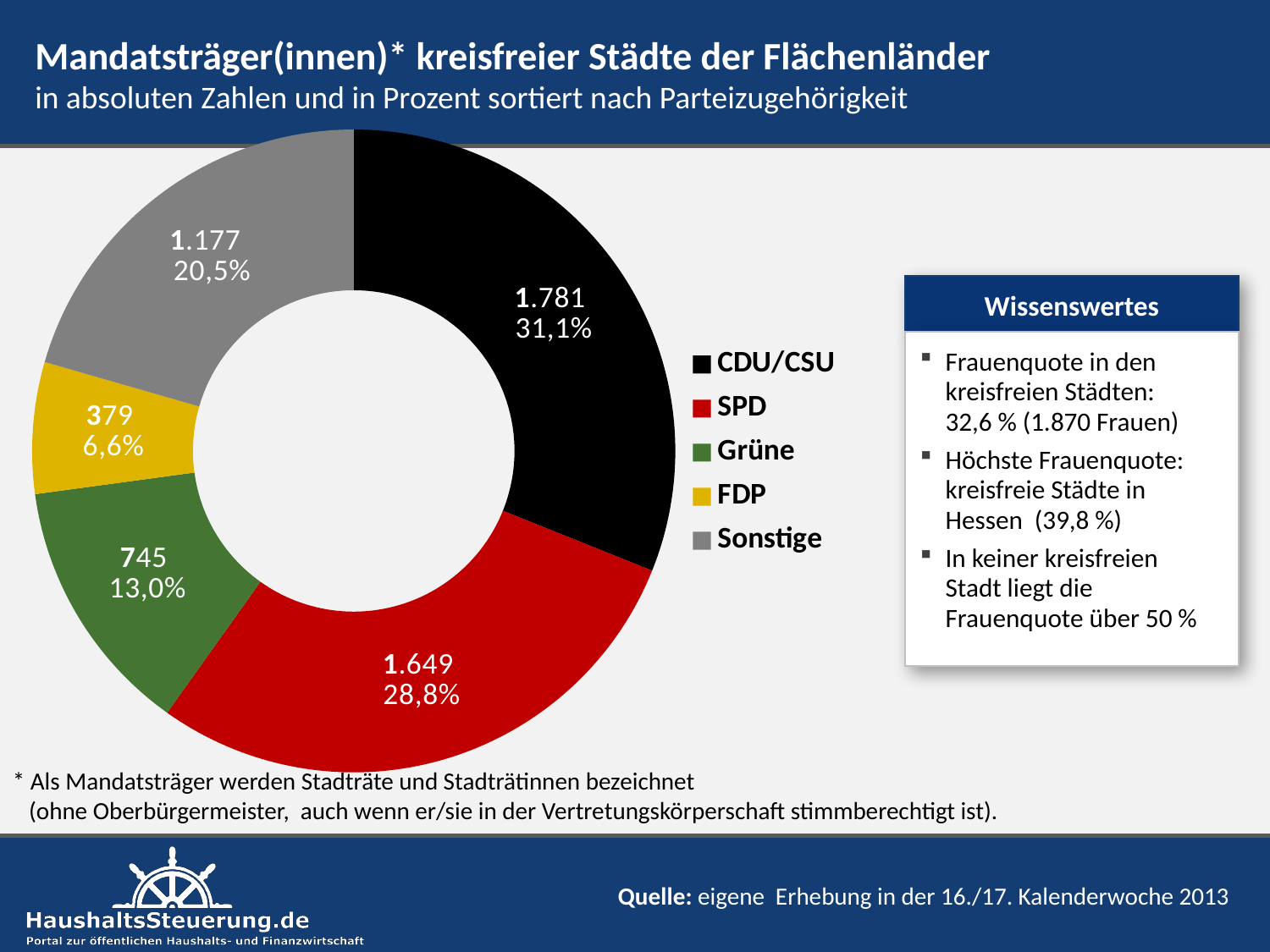
What is the difference in absolute numbers between CDU/CSU and SPD? 132 How many mandate holders does the chart show for CDU/CSU? 1.781 Which party has the largest slice of the chart? CDU/CSU What is the absolute number shown for Sonstige? 1.177 How many parties/categories does the chart show? 5 Which has more mandate holders, Sonstige or Grüne? Sonstige What is the absolute number shown for Grüne? 745 What kind of chart is shown on the slide? doughnut chart Which party has the smallest slice of the chart? FDP What percentage is shown for the FDP slice? 6,6% What percentage share does the SPD slice have? 28,8% Which colour represents the SPD in the chart? red